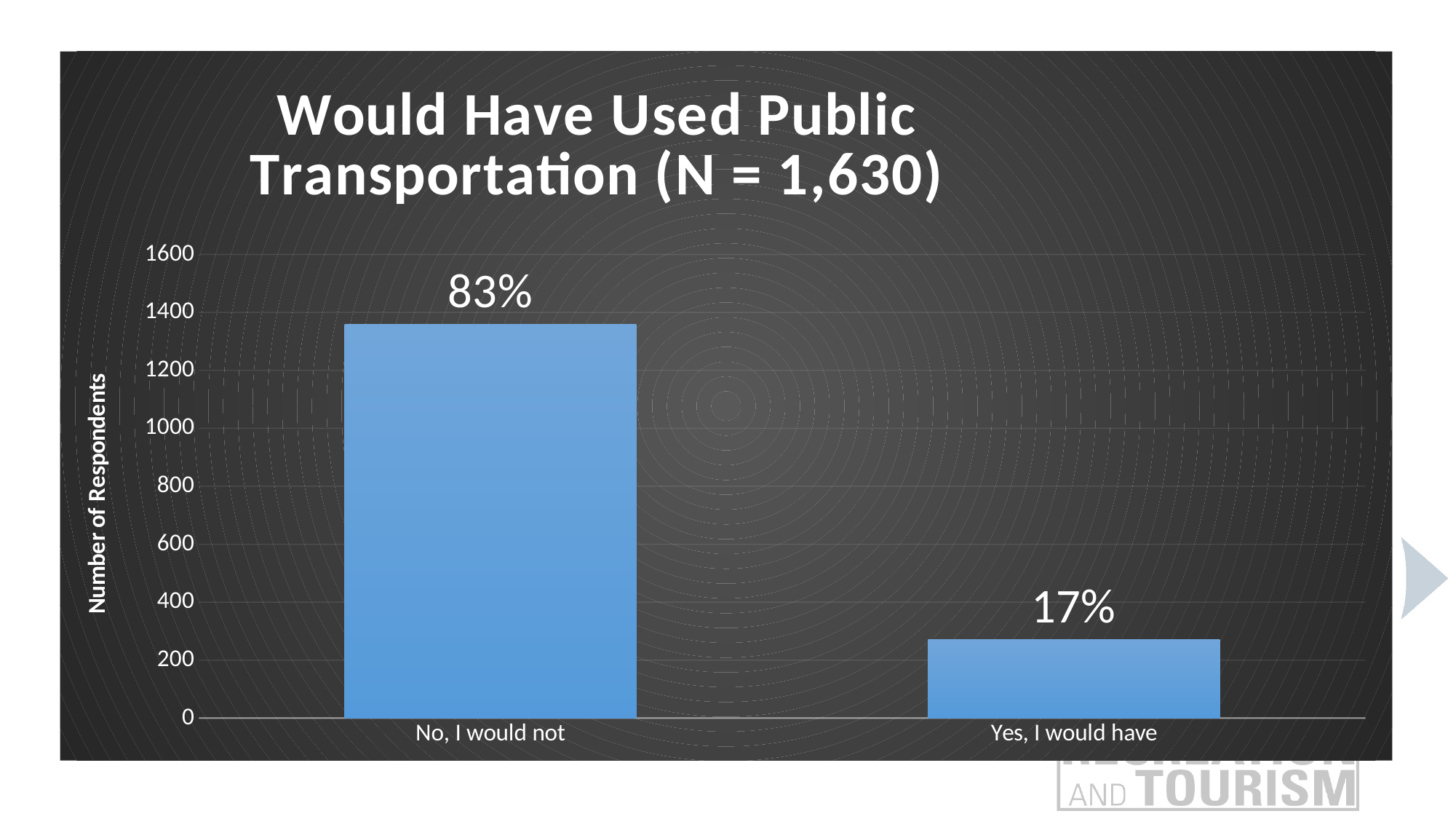
What is the difference in percentage points between the labels for "No, I would not" and "Yes, I would have"? 66 percentage points What is the title of the chart? Would Have Used Public Transportation (N = 1,630) What is the label on the vertical axis? Number of Respondents Which category has the lowest bar? Yes, I would have Is the number of respondents for "Yes, I would have" greater or less than 400? less Which is larger, the bar for "No, I would not" or the bar for "Yes, I would have"? No, I would not What is the data label shown above the bar for "No, I would not"? 83% Which category has the highest bar? No, I would not What kind of chart is shown on the slide? bar chart What is the data label shown above the bar for "Yes, I would have"? 17% How many categories are shown on the x axis? 2 Is the number of respondents for "No, I would not" greater or less than 1200? greater